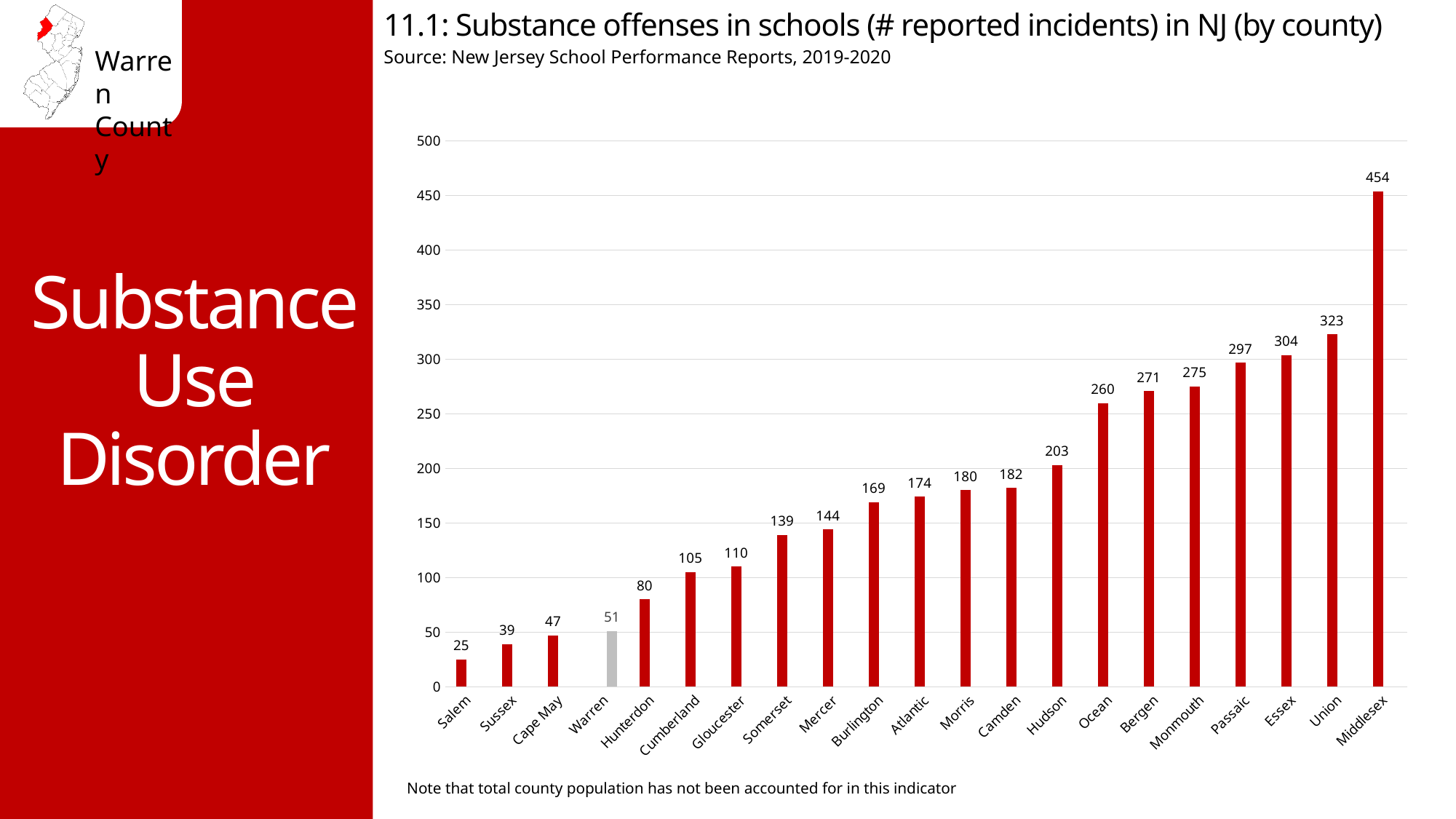
Which county has the highest number of reported substance offense incidents? Middlesex Which county has the lowest number of reported substance offense incidents? Salem What kind of chart is shown on the slide? Bar chart Which county's bar is shown in gray instead of red? Warren Which county has a larger value, Ocean or Hudson? Ocean What is the difference between the values for Warren and Salem? 26 What is the difference between the values for Middlesex and Union? 131 What is the value shown for Middlesex County? 454 How many reported incidents are shown for Hunterdon County? 80 How many counties are shown on the chart? 21 What is the number of reported substance offense incidents in schools for Warren County? 51 Is the value for Bergen greater or less than 250? greater